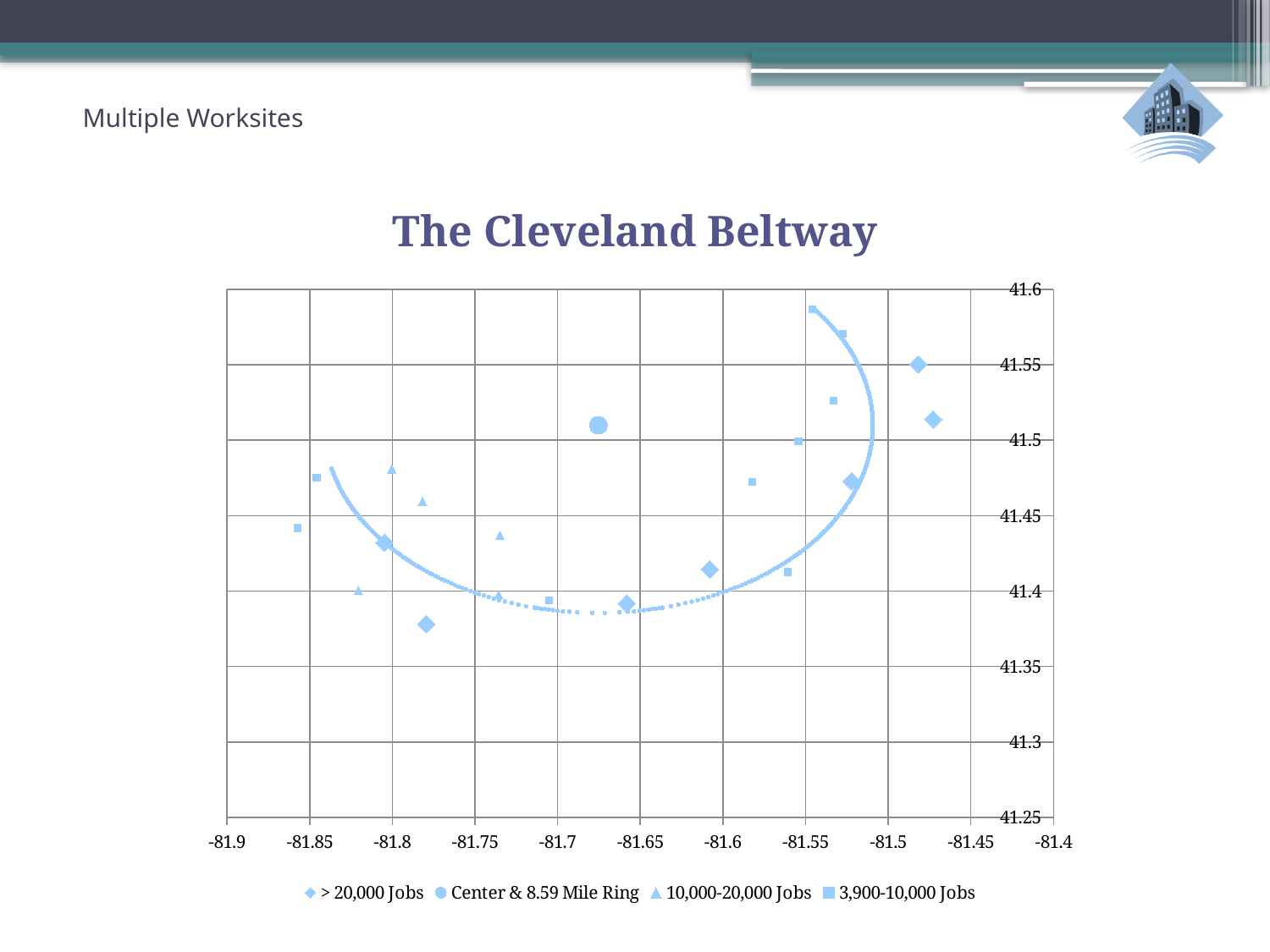
What kind of chart is shown on the slide? Scatter chart How many diamond markers (> 20,000 Jobs) are plotted on the chart? 7 What is the title of the chart? The Cleveland Beltway Is the y value of the Center & 8.59 Mile Ring point greater or less than 41.45? greater Which legend series is represented by a circle marker? Center & 8.59 Mile Ring Is the y value of the highest > 20,000 Jobs diamond greater or less than 41.5? greater How many series does the legend list? 4 Is the y value of the highest 3,900-10,000 Jobs square greater or less than 41.55? greater